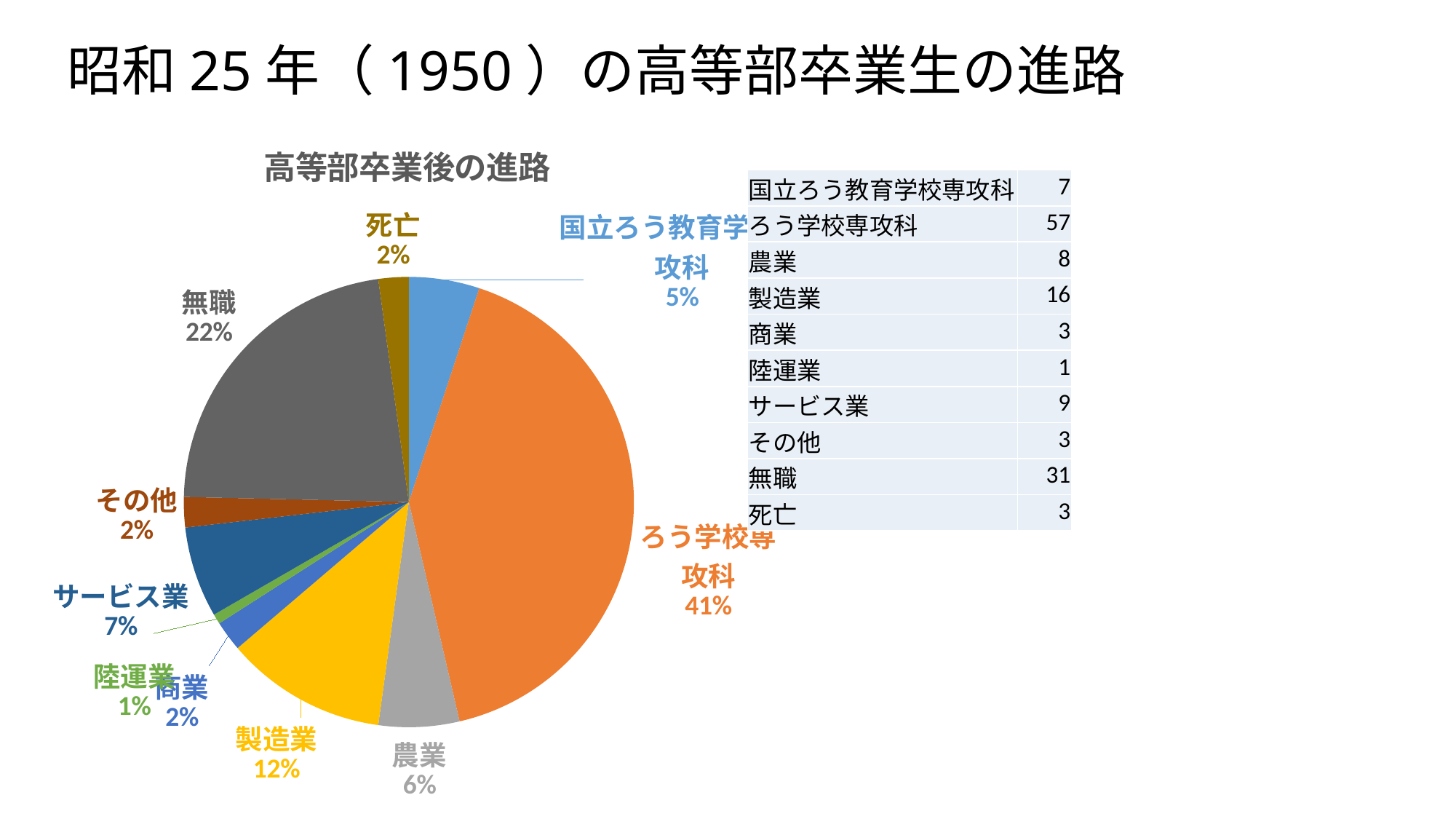
What kind of chart is shown on the slide? pie chart What percentage does the サービス業 slice show? 7% What percentage does the 製造業 slice show? 12% What colour is the ろう学校専攻科 slice? orange Which category has the smallest share of the pie? 陸運業 What percentage does the 無職 slice show? 22% What is the title of the pie chart? 高等部卒業後の進路 Which category has the largest share of the pie? ろう学校専攻科 What percentage does the ろう学校専攻科 slice show? 41% What is the difference in percentage points between the 無職 slice and the 国立ろう教育学校専攻科 slice? 17 Which is larger, the share for 農業 or the share for 製造業? 製造業 How many slices does the pie chart have? 10